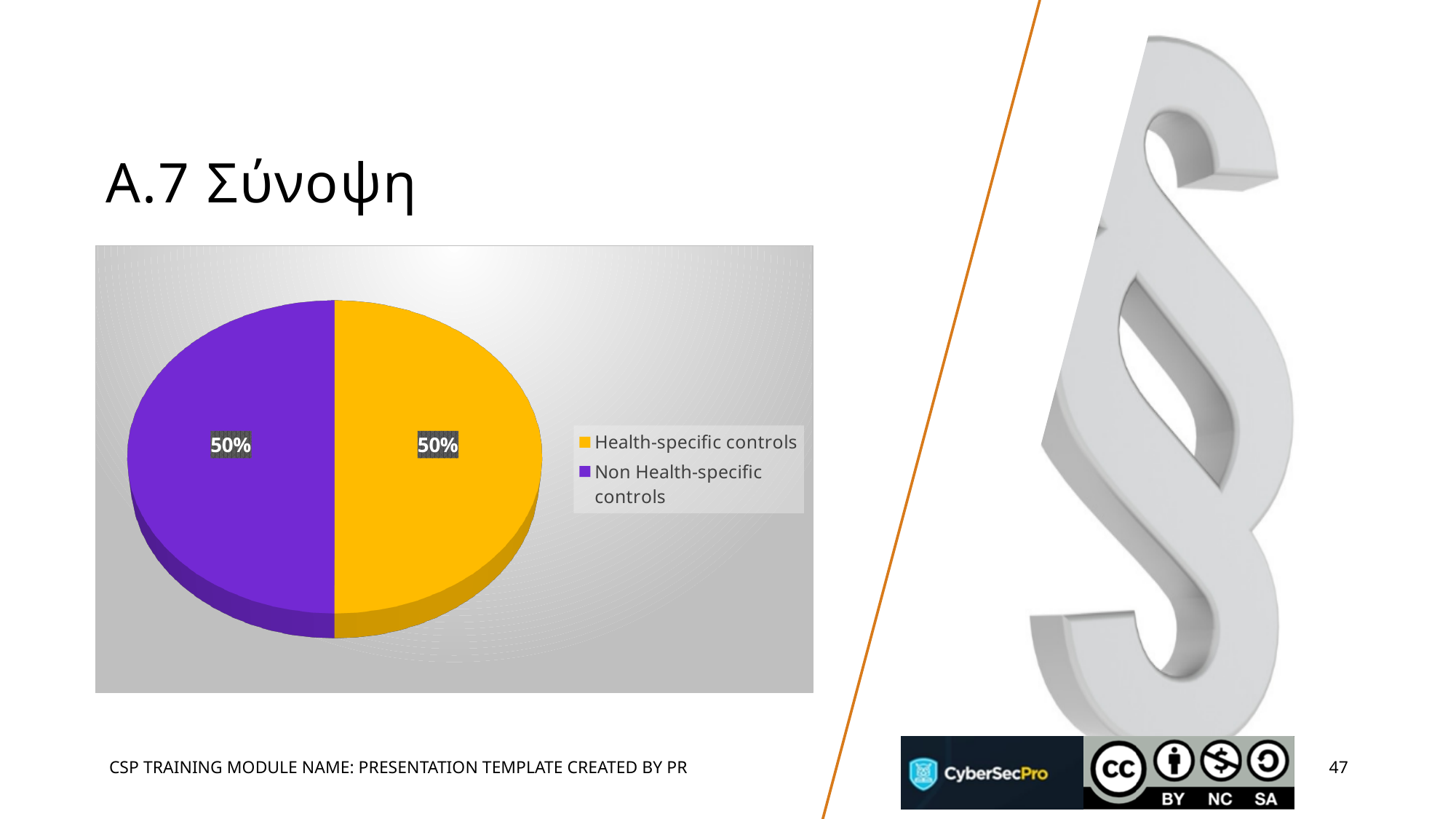
What is the value shown for the Non Health-specific controls slice? 50% What is the combined share of the two slices? 100% Which colour represents Non Health-specific controls in the pie chart? purple How many slices does the pie chart have? 2 Is the share for Health-specific controls larger or smaller than the share for Non Health-specific controls? equal Which colour represents Health-specific controls in the pie chart? yellow What is the difference between the Health-specific controls share and the Non Health-specific controls share? 0% What kind of chart is shown on the slide? pie chart What share of the pie is Health-specific controls? 50% How many entries does the legend list? 2 What share of the pie is Non Health-specific controls? 50% What is the value shown for the Health-specific controls slice? 50%